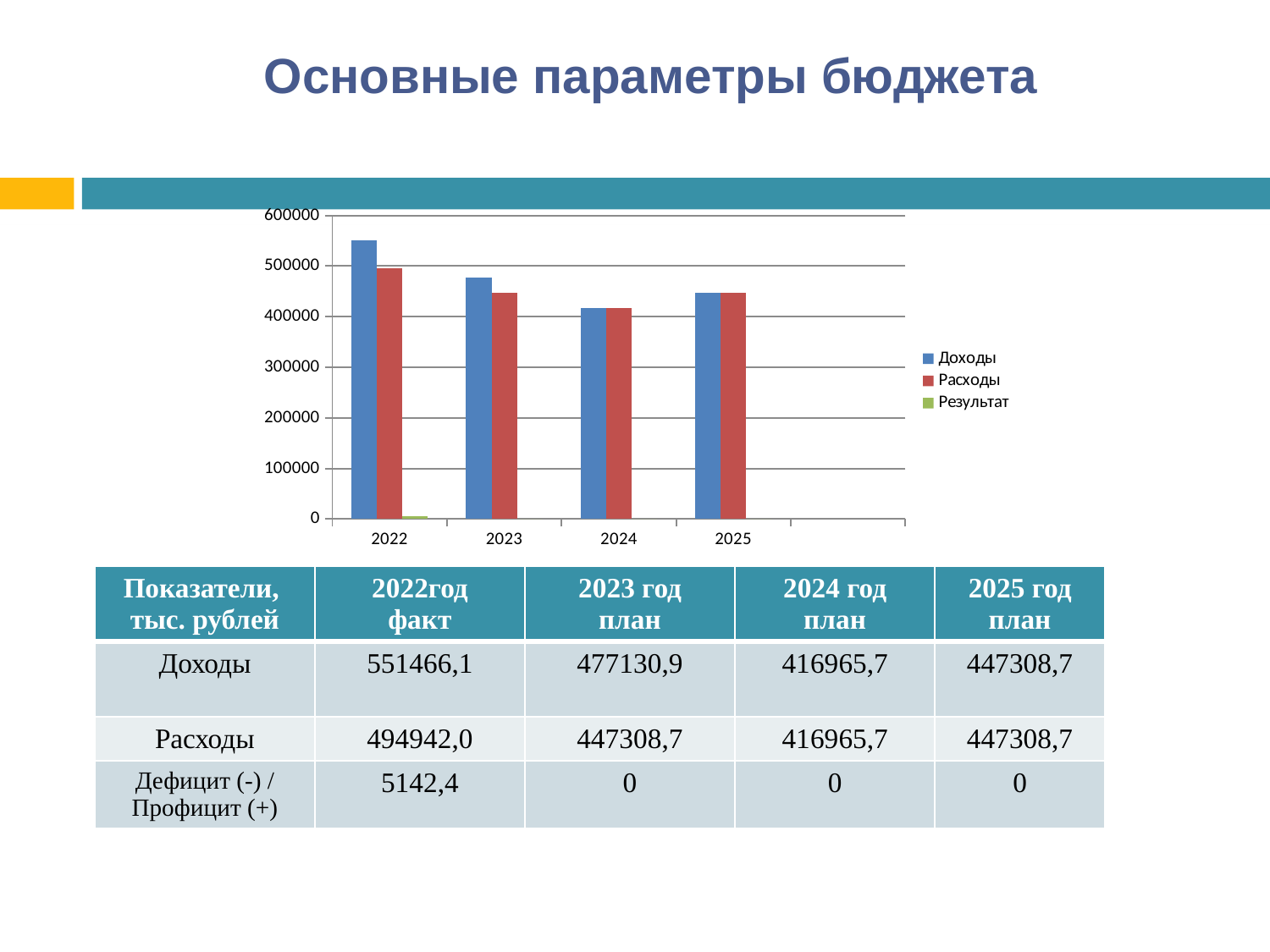
Is the Доходы value for 2024 greater or less than 400000? greater According to the table under the chart, what is the Доходы value for 2022? 551466,1 What are the three entries in the chart legend? Доходы, Расходы, Результат How many series does the chart legend list? 3 Which year has the lowest Доходы bar? 2024 How many years are shown on the x axis of the chart? 4 Is the Расходы value for 2022 greater or less than 500000? less Do the Доходы bars rise or fall from 2022 to 2024? fall Is the Доходы value for 2022 greater or less than 500000? greater Which year has the highest Доходы bar? 2022 What kind of chart is shown on the slide? bar chart In 2022, which is larger, Доходы or Расходы? Доходы